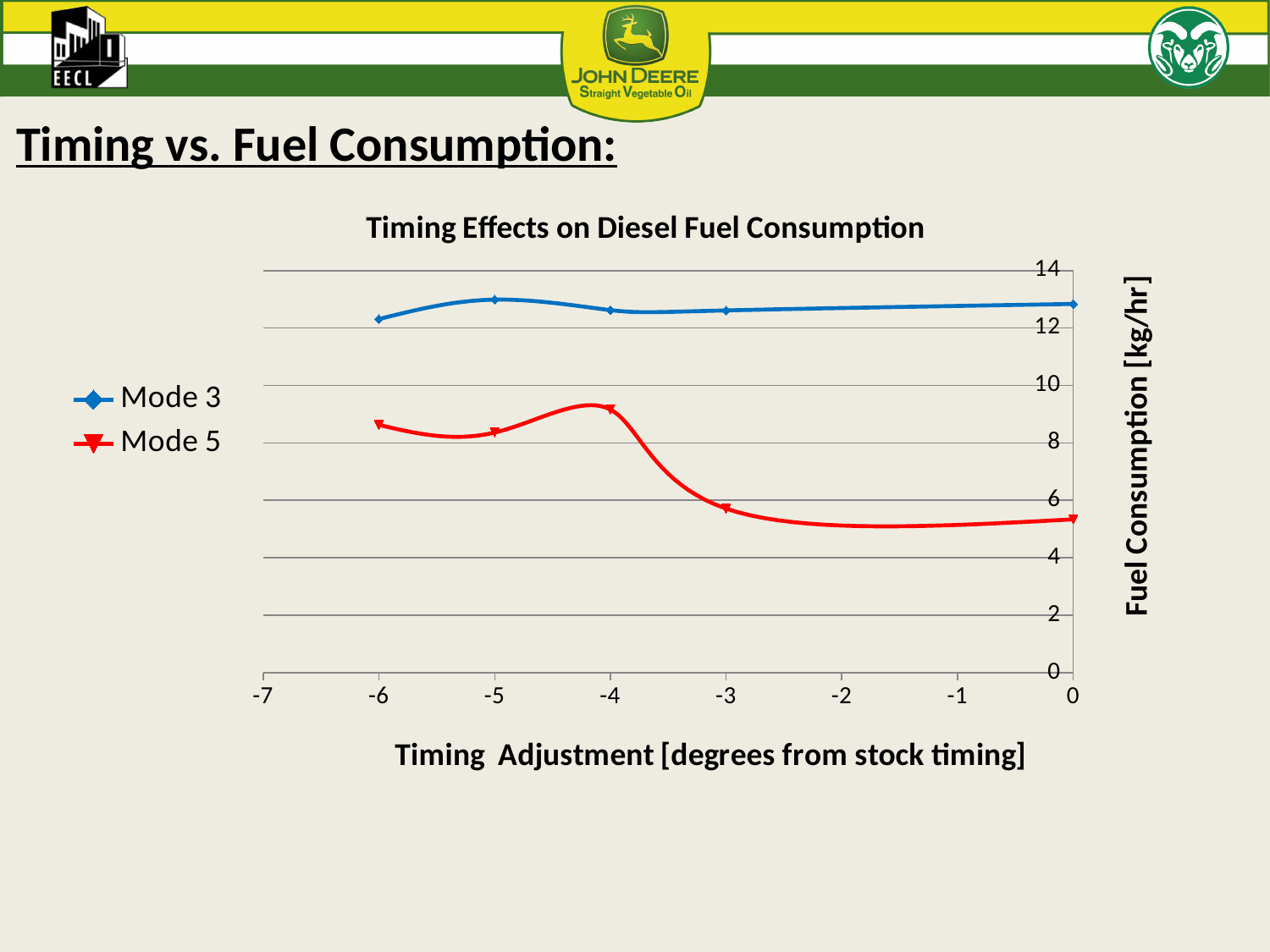
How many data points are plotted for the Mode 5 series? 5 Is the Mode 3 value at a timing adjustment of -6 greater or less than 12? greater Is the Mode 5 value at a timing adjustment of -3 greater or less than 6? less At which timing adjustment does the Mode 5 series reach its highest fuel consumption? -4 Is the Mode 5 value at a timing adjustment of -4 greater or less than 8? greater What are the names of the two series in the legend? Mode 3 and Mode 5 How many series does the legend list? 2 What is the title of the chart? Timing Effects on Diesel Fuel Consumption Does the Mode 5 fuel consumption rise or fall between timing adjustments of -4 and -3? fall At a timing adjustment of -4, which series has the higher fuel consumption, Mode 3 or Mode 5? Mode 3 What type of chart is shown on the slide? line chart